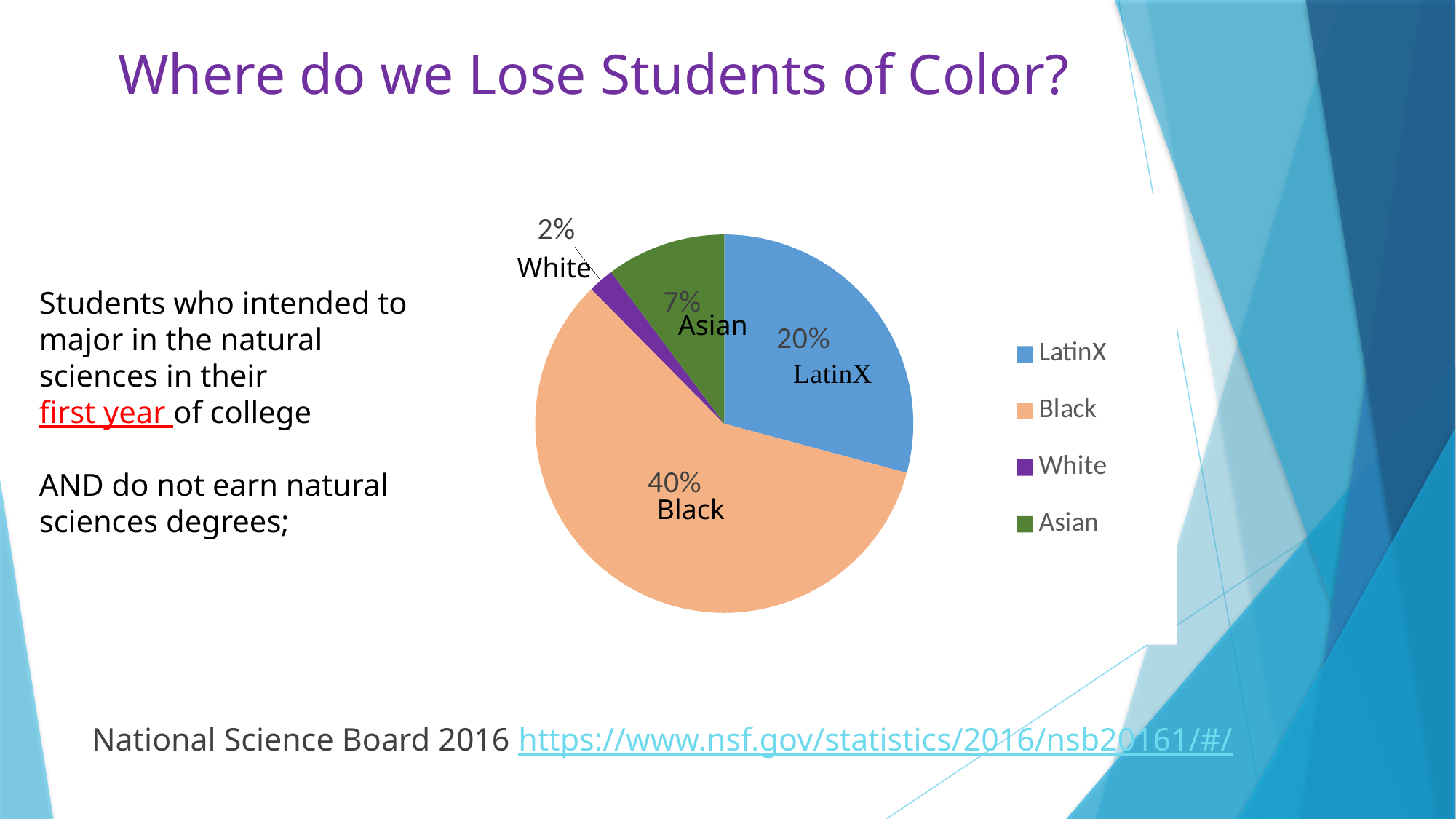
How many entries does the legend of the pie chart list? 4 What is the difference in percentage points between the Black slice and the LatinX slice? 20 percentage points Which is larger in the pie chart, the LatinX slice or the Asian slice? LatinX What percentage is shown for the Black slice of the pie chart? 40% How many categories does the pie chart show? 4 What percentage is shown for the LatinX slice of the pie chart? 20% Which category has the smallest slice of the pie chart? White What percentage is shown for the White slice of the pie chart? 2% What colour is the Black slice in the pie chart? Orange (peach) What percentage is shown for the Asian slice of the pie chart? 7% Which category has the largest slice of the pie chart? Black What kind of chart is shown on the slide? Pie chart